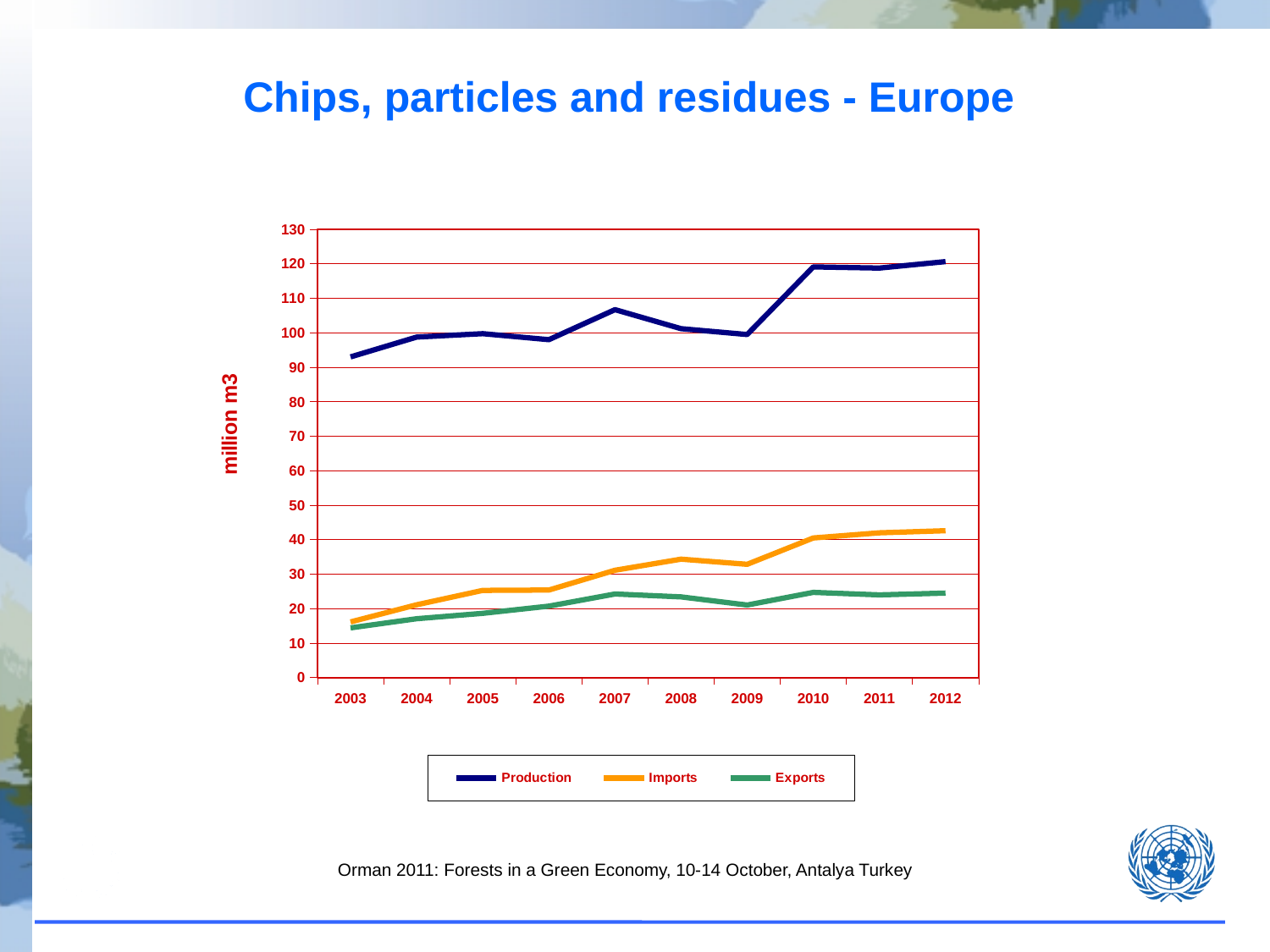
In which year are Imports lowest? 2003 How many years are plotted along the x axis? 10 What kind of chart is shown on the slide? line chart Do Imports generally rise or fall from 2003 to 2012? rise Is the value for Production in 2010 greater or less than 110? greater Which is larger, Production in 2007 or Production in 2008? 2007 In which year is Production lowest? 2003 Is the value for Imports in 2012 greater or less than 40? greater Is the value for Production in 2003 greater or less than 100? less What is the label on the y axis? million m3 How many series does the legend list? 3